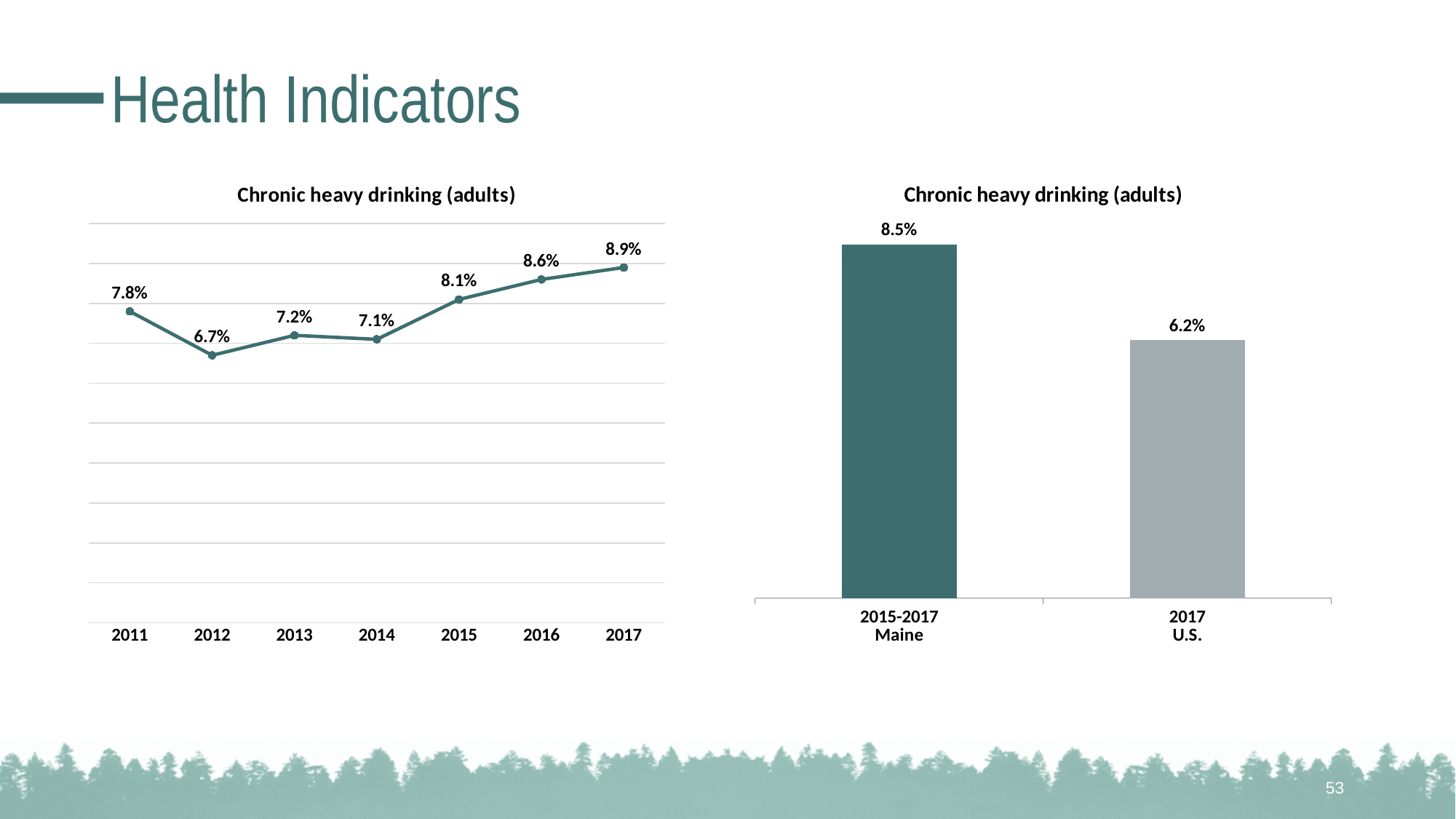
In the right bar chart, what is the value for 2017 U.S.? 6.2% In the left line chart, how many years are plotted? 7 In the left line chart, what is the value for 2011? 7.8% In the left line chart, which is larger, the value for 2013 or the value for 2014? 2013 In the left line chart, what is the difference between the 2017 value and the 2011 value? 1.1% In the left line chart, which year has the highest value? 2017 What kind of chart is the chart on the right? bar chart In the left line chart, do the values rise or fall from 2014 to 2017? rise In the left line chart, what is the value for 2014? 7.1% What is the title of the chart on the left? Chronic heavy drinking (adults) In the left line chart, which year has the lowest value? 2012 In the right bar chart, what is the difference between the 2015-2017 Maine value and the 2017 U.S. value? 2.3%